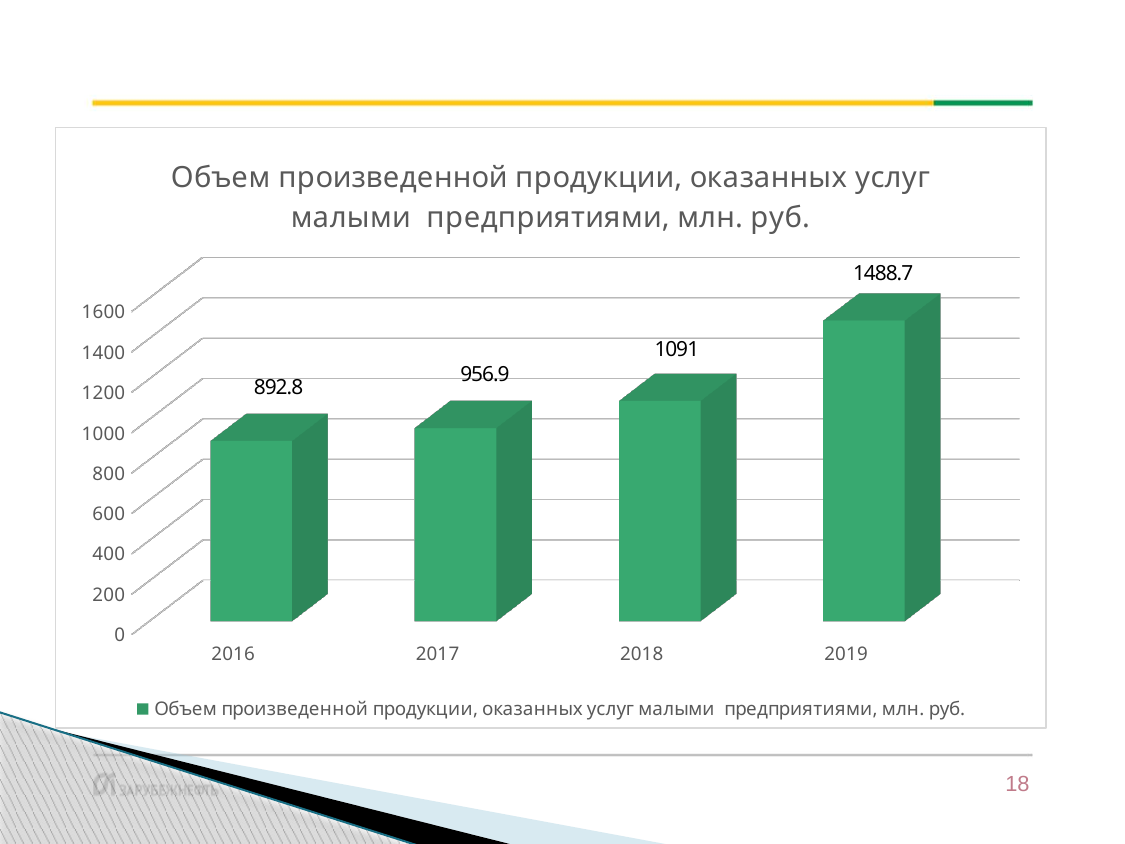
How many years are shown on the x axis? 4 Which year has the highest value? 2019 What is the value for 2016? 892.8 Which is larger, the value for 2017 or the value for 2018? 2018 Do the values rise or fall from 2016 to 2019? rise Is the value for 2017 greater or less than 1000? less Which year has the lowest value? 2016 What is the value for 2018? 1091 What kind of chart is this? bar chart What is the value for 2019? 1488.7 What is the difference between the values for 2019 and 2018? 397.7 What is the difference between the values for 2017 and 2016? 64.1